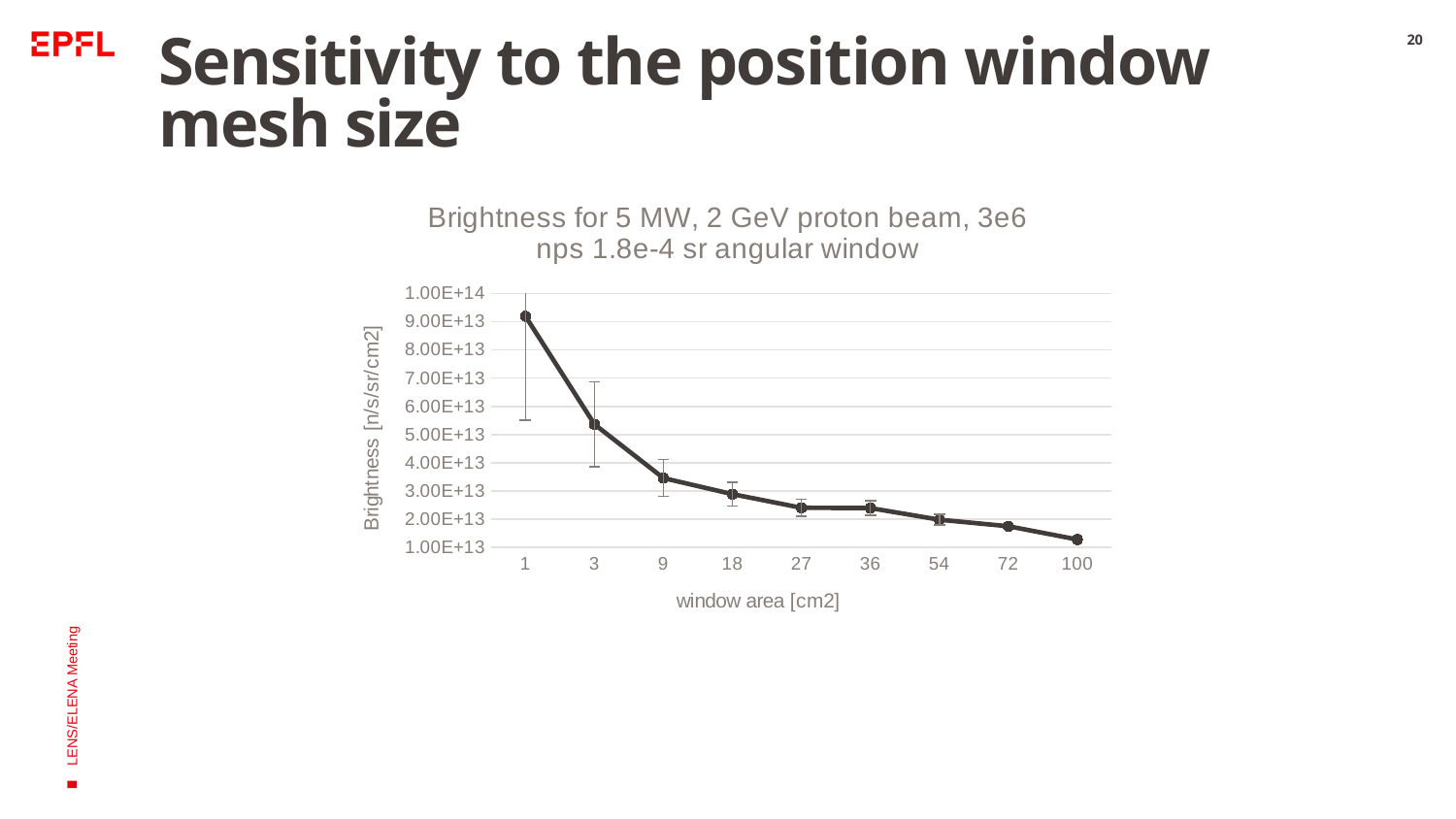
What is the label of the x axis? window area [cm2] What is the label of the y axis? Brightness [n/s/sr/cm2] Which window area has the highest brightness? 1 Is the brightness for window area 9 greater or less than 4.00E+13? less Which has the larger brightness, window area 3 or window area 9? 3 Is the brightness for window area 100 greater or less than 2.00E+13? less Is the brightness for window area 1 greater or less than 8.00E+13? greater How many window area values are plotted on the x axis? 9 Which window area has the lowest brightness? 100 Does the brightness rise or fall as the window area increases along the x axis? Fall What kind of chart is shown on the slide? Line chart